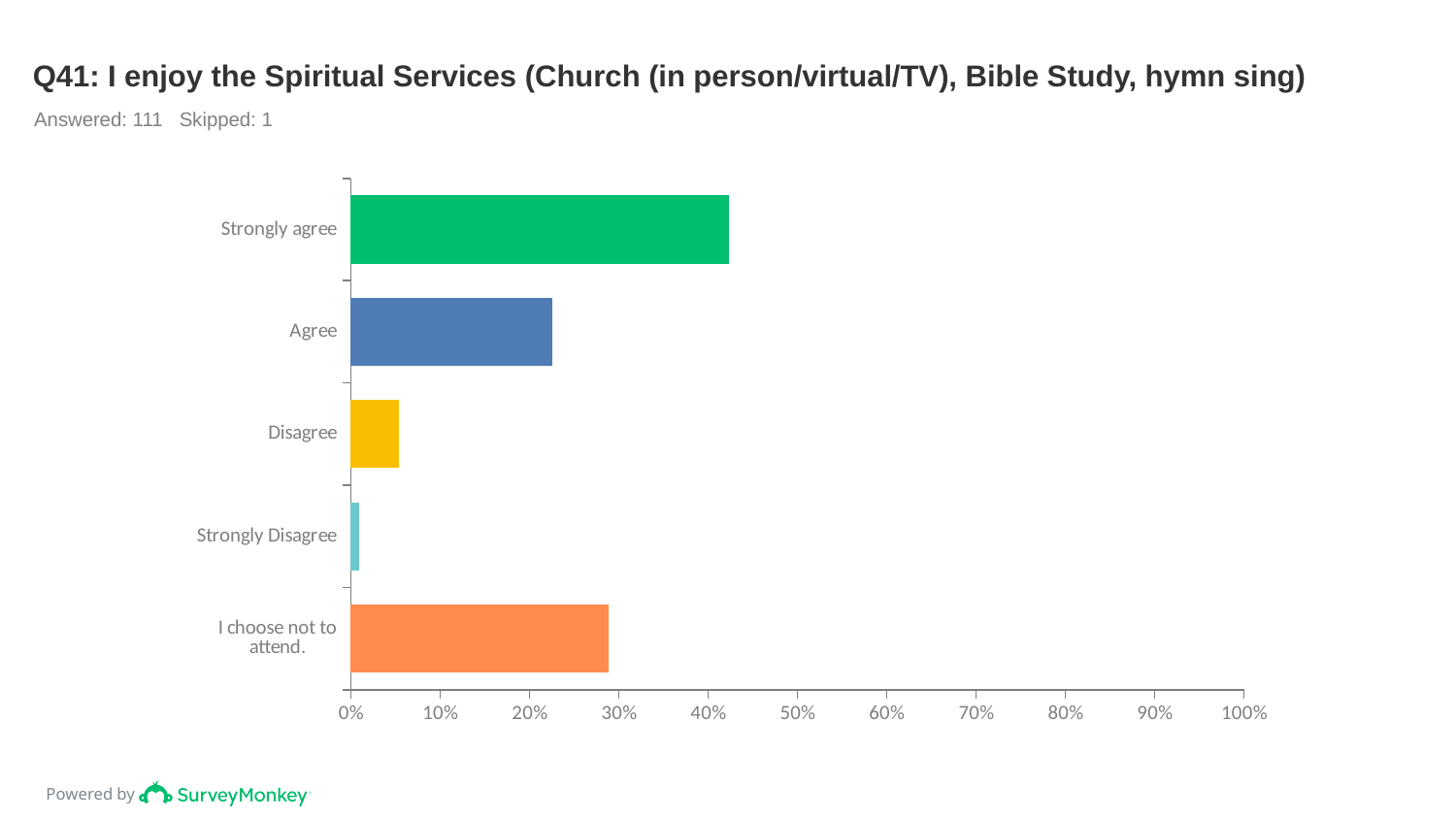
How many respondents answered this question according to the slide? 111 Which response category has the highest value? Strongly agree Is the value for Agree greater or less than 30%? less What kind of chart is shown on the slide? bar chart How many response categories are shown on the chart? 5 Is the value for Strongly agree greater or less than 40%? greater Which is larger, the value for Disagree or the value for Strongly Disagree? Disagree Which response category has the lowest value? Strongly Disagree Is the value for 'I choose not to attend.' greater or less than 20%? greater Which is larger, the value for Agree or the value for 'I choose not to attend.'? I choose not to attend. What colour is the bar for Strongly agree? green